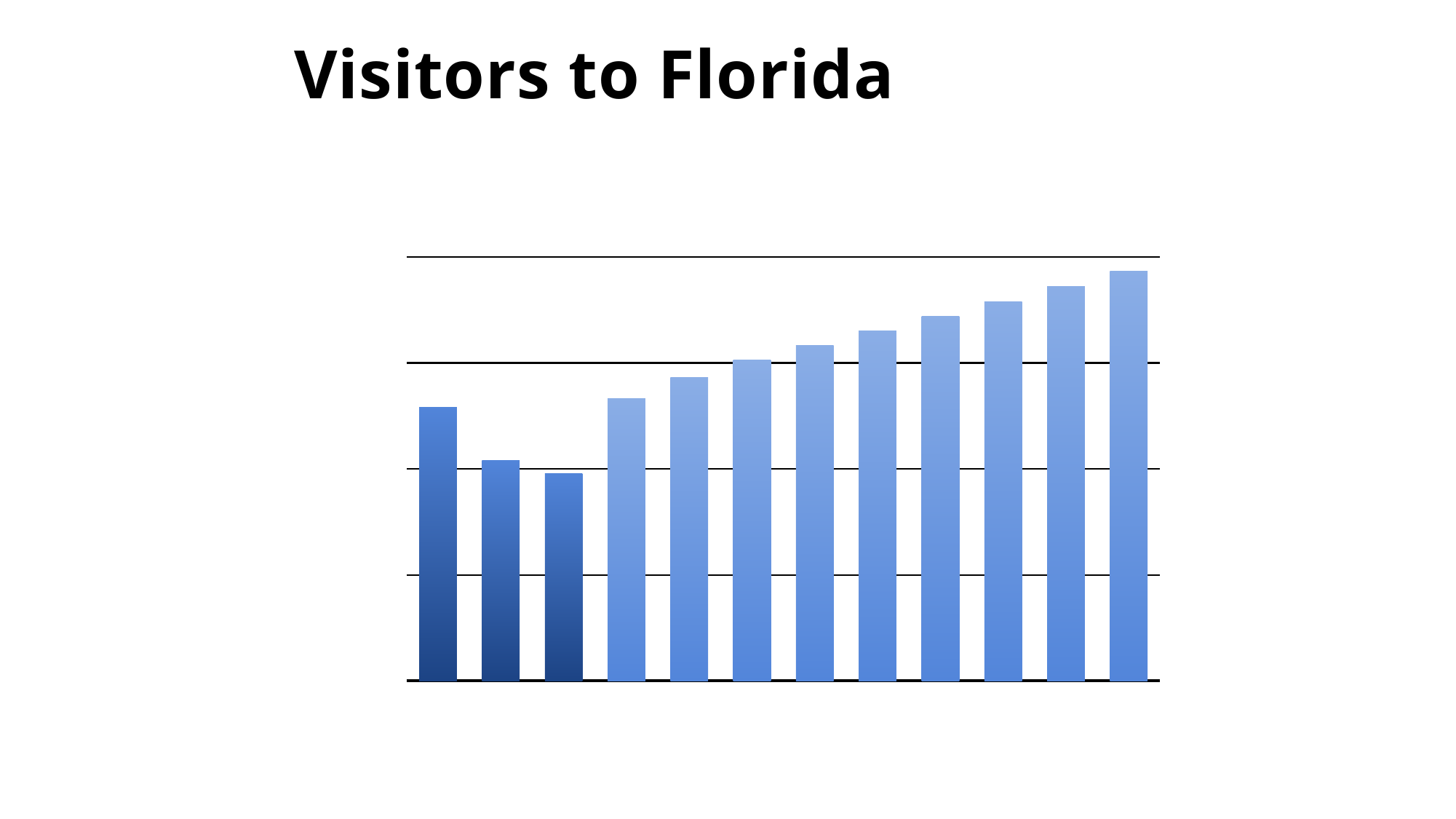
Is the rightmost bar taller or shorter than the leftmost bar? taller Is the fourth bar from the left taller or shorter than the third bar? taller Which bar is the shortest in the chart? the third bar from the left How many bars are plotted in the chart? 12 Which bar is the tallest in the chart? the rightmost (12th) bar What is the title of the chart? Visitors to Florida How many bars are shaded in the darker blue colour? 3 Do the first three bars rise or fall moving left to right? fall From the fourth bar onward, do the bar values rise or fall moving left to right? rise Is the first (leftmost) bar taller or shorter than the second bar? taller What type of chart is shown on the slide? bar chart